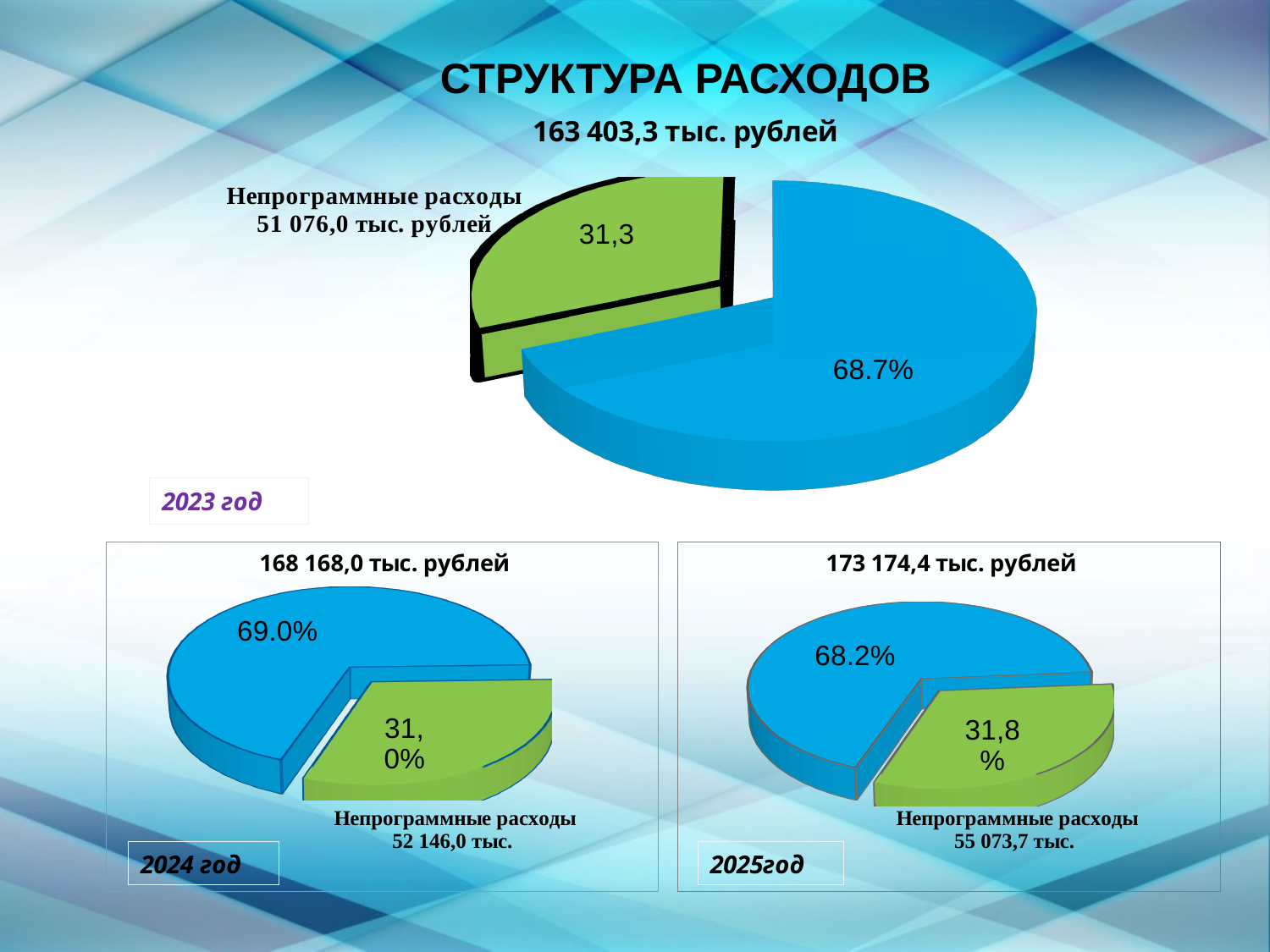
How many pie charts are shown on the slide? 3 What total amount is shown above the 2024 год pie chart? 168 168,0 тыс. рублей In the 2023 год pie chart, what share is shown for the blue slice? 68.7% In the 2025год pie chart, what share is shown for the blue slice? 68.2% In the 2023 год pie chart, what share is shown for the green slice labelled Непрограммные расходы? 31,3 In the 2024 год pie chart, what share is shown for the blue slice? 69.0% What amount of Непрограммные расходы is stated next to the 2025год pie chart? 55 073,7 тыс. How many slices does the 2024 год pie chart have? 2 In the 2025год pie chart, which slice is larger, the blue slice or the green Непрограммные расходы slice? the blue slice In the 2025год pie chart, what share is shown for the green slice labelled Непрограммные расходы? 31,8% In the 2024 год pie chart, what share is shown for the green slice labelled Непрограммные расходы? 31,0% What kind of chart is used for the 2023 год data on the slide? pie chart